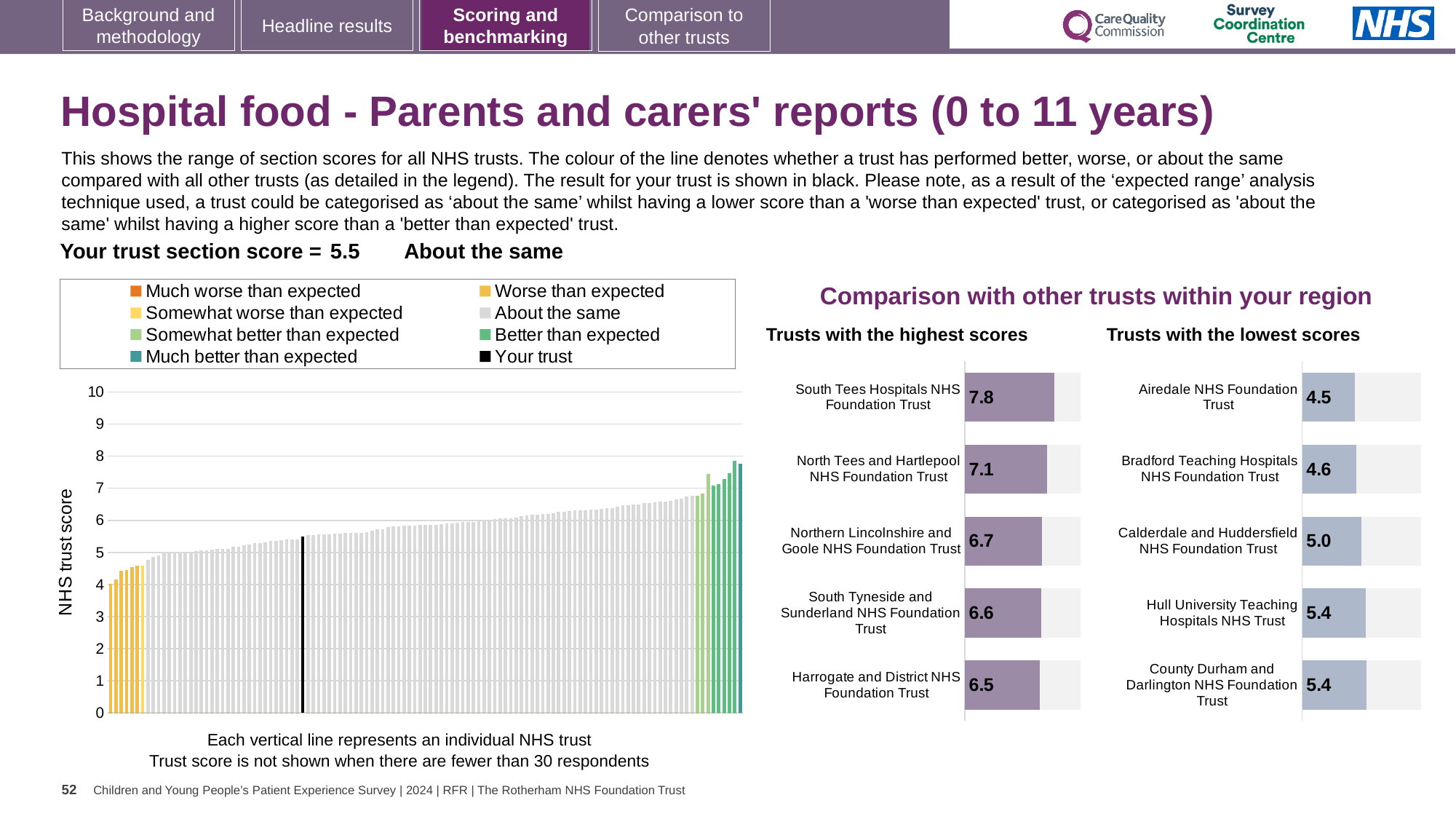
In the 'Trusts with the lowest scores' chart, what is the score for Airedale NHS Foundation Trust? 4.5 In the 'Trusts with the highest scores' chart, which trust has the highest score? South Tees Hospitals NHS Foundation Trust In the 'Trusts with the highest scores' chart, what is the score for Harrogate and District NHS Foundation Trust? 6.5 In the main NHS trust score chart on the left, do the bar values rise or fall from left to right? rise In the 'Trusts with the highest scores' chart, what is the difference between the scores of South Tees Hospitals NHS Foundation Trust and Harrogate and District NHS Foundation Trust? 1.3 How many entries does the legend of the main NHS trust score chart on the left list? 8 How many trusts are shown in the 'Trusts with the highest scores' chart? 5 In the 'Trusts with the highest scores' chart, what is the score for South Tees Hospitals NHS Foundation Trust? 7.8 In the 'Trusts with the lowest scores' chart, what is the difference between the scores of Hull University Teaching Hospitals NHS Trust and Airedale NHS Foundation Trust? 0.9 In the 'Trusts with the lowest scores' chart, what is the score for Calderdale and Huddersfield NHS Foundation Trust? 5.0 In the 'Trusts with the lowest scores' chart, which trust has the lowest score? Airedale NHS Foundation Trust In the main NHS trust score chart on the left, what is the section score for your trust (the black bar)? 5.5